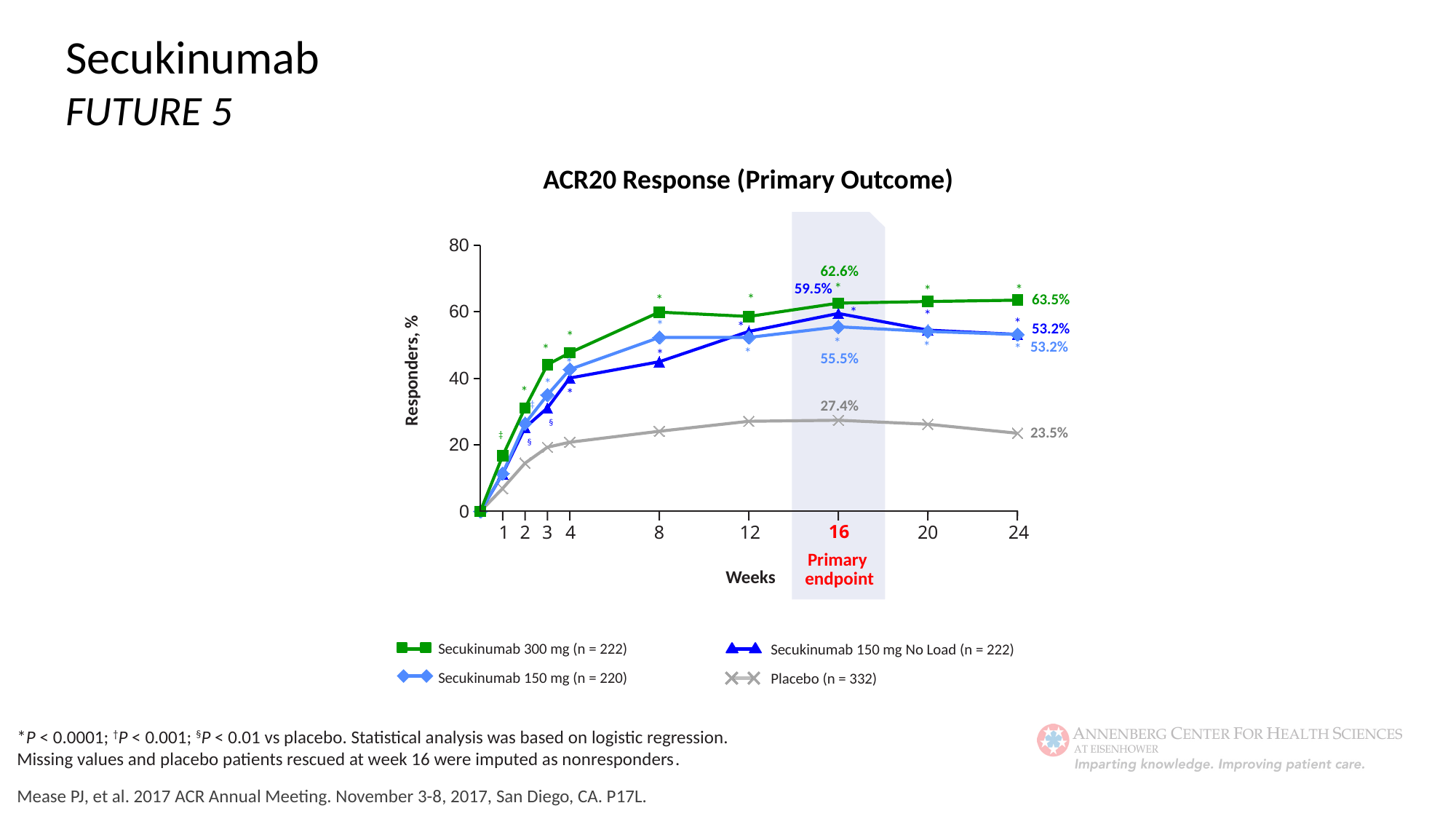
Which series has the highest ACR20 response at week 16? Secukinumab 300 mg (n = 222) Is the ACR20 response for Secukinumab 150 mg at week 8 greater or less than 40? greater What is the ACR20 response for Placebo at week 16? 27.4% How many series does the legend list? 4 What is the ACR20 response for Secukinumab 150 mg No Load at week 16? 59.5% What is the ACR20 response for Secukinumab 300 mg at week 24? 63.5% Which series has the lowest ACR20 response at week 24? Placebo (n = 332) What is the title of the chart? ACR20 Response (Primary Outcome) What is the ACR20 response for Placebo at week 24? 23.5% What is the ACR20 response for Secukinumab 300 mg at week 16? 62.6% What type of chart is shown on the slide? line chart What is the difference between the Secukinumab 300 mg and Placebo ACR20 responses at week 16? 35.2 percentage points